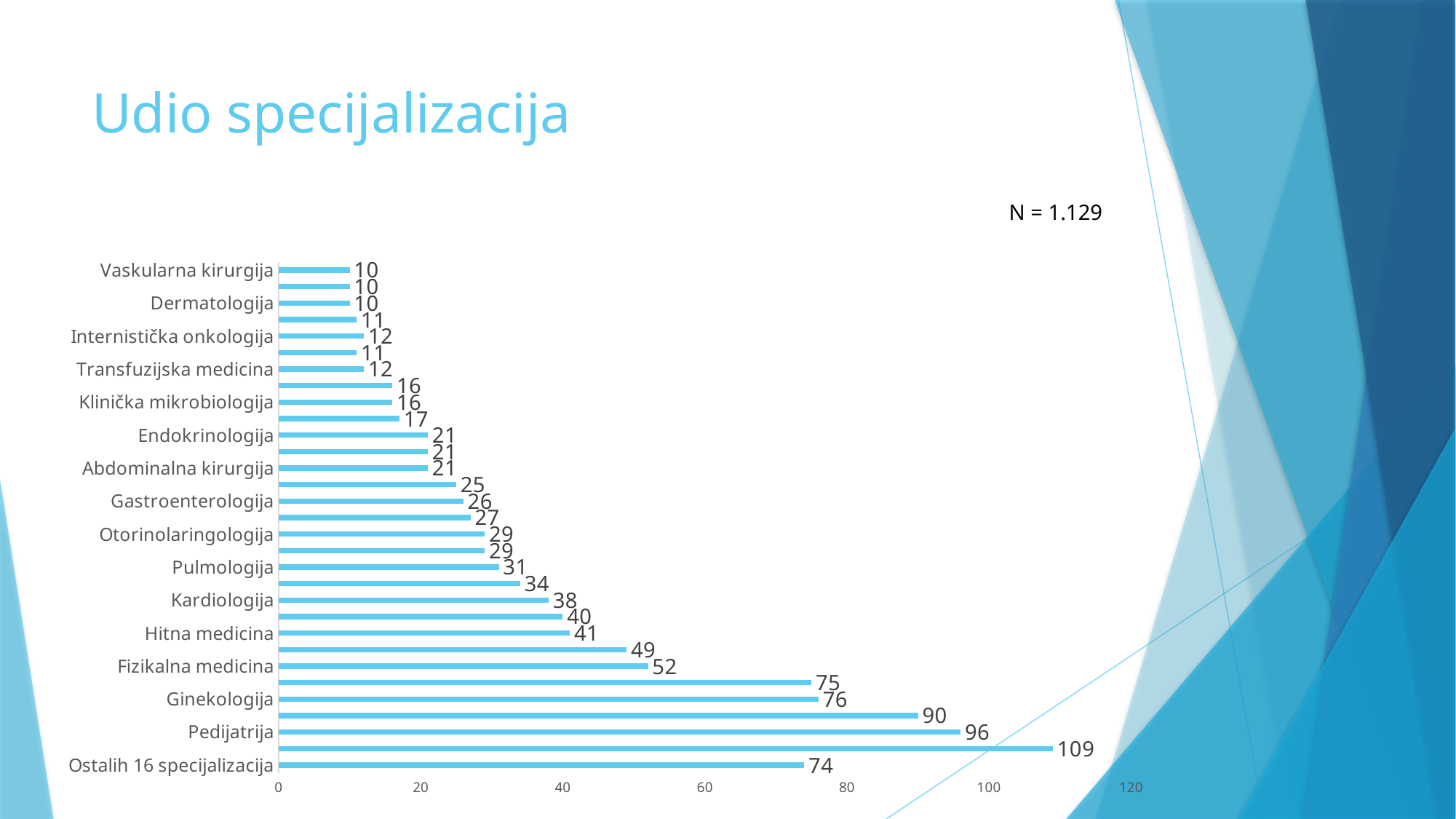
What sample size (N) is stated on the slide? N = 1.129 What is the value for Endokrinologija? 21 What is the value for Fizikalna medicina? 52 What is the value for Ostalih 16 specijalizacija? 74 What is the title of the slide? Udio specijalizacija Which has a larger value, Hitna medicina or Kardiologija? Hitna medicina What is the largest value plotted on the chart? 109 What is the value for Pedijatrija? 96 What is the value for Ginekologija? 76 What kind of chart is shown on the slide? bar chart What is the difference between the values for Pedijatrija and Ginekologija? 20 What is the value for Kardiologija? 38